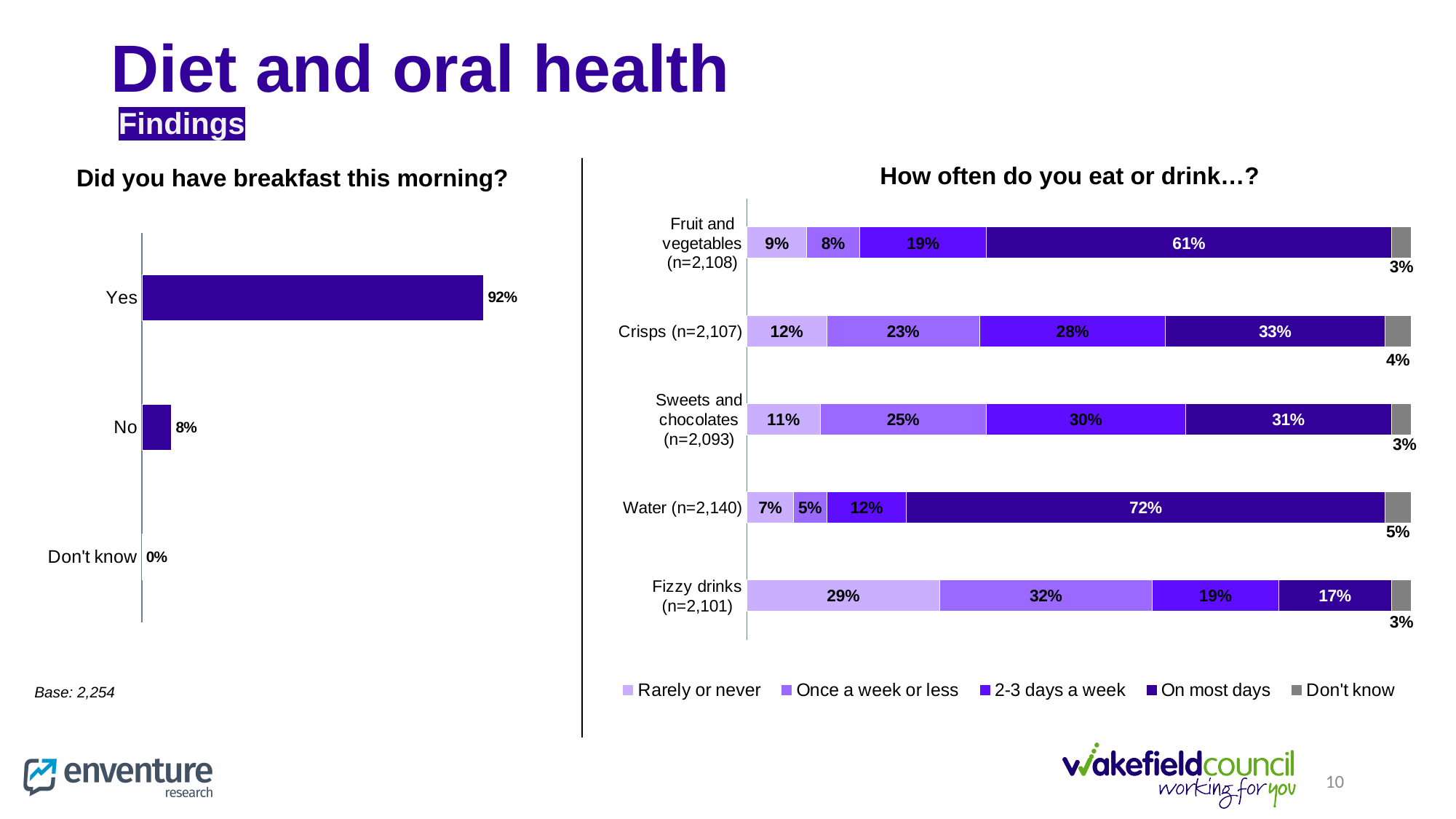
In the 'Did you have breakfast this morning?' chart, what percentage answered No? 8% In the 'How often do you eat or drink…?' chart, what percentage eat or drink Water on most days? 72% In the 'How often do you eat or drink…?' chart, which item has the lowest 'On most days' value? Fizzy drinks In the 'How often do you eat or drink…?' chart, how many series does the legend list? 5 In the 'How often do you eat or drink…?' chart, what percentage have Fizzy drinks rarely or never? 29% In the 'Did you have breakfast this morning?' chart, what percentage answered Yes? 92% What kind of chart is the 'How often do you eat or drink…?' chart? Stacked bar chart In the 'How often do you eat or drink…?' chart, which item has the highest 'On most days' value? Water In the 'Did you have breakfast this morning?' chart, what is the difference between the Yes and No values? 84% In the 'Did you have breakfast this morning?' chart, how many categories are shown? 3 In the 'Did you have breakfast this morning?' chart, which category has the highest value? Yes In the 'How often do you eat or drink…?' chart, what percentage eat Crisps 2-3 days a week? 28%